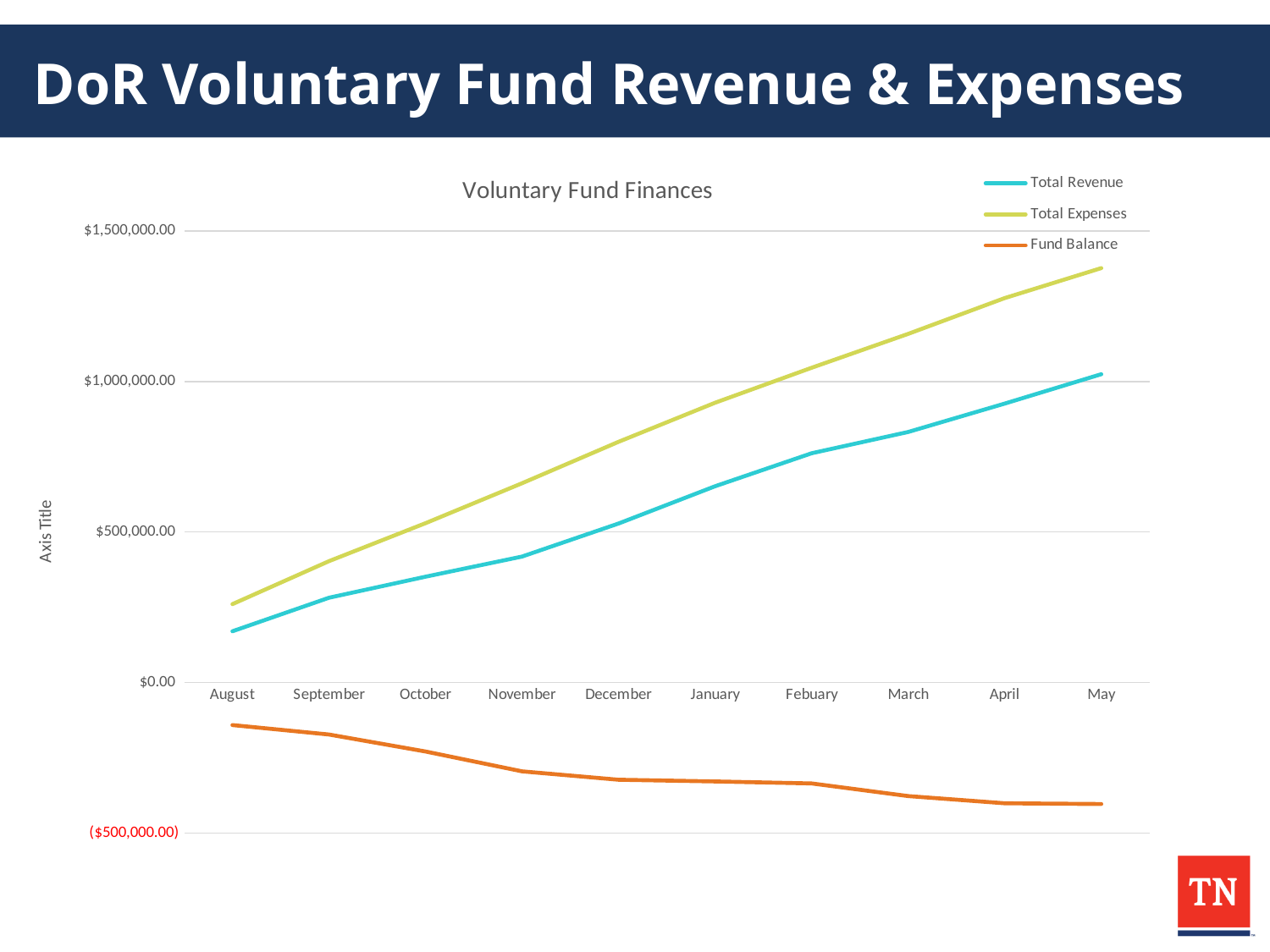
In December, which is larger: Total Expenses or Total Revenue? Total Expenses What kind of chart is shown on the slide? line chart Does Total Revenue rise or fall from August to May? rise In which month is Total Expenses highest? May Does Fund Balance rise or fall from August to May? fall How many series does the legend list? 3 Which series is drawn in orange? Fund Balance Is the value for Total Revenue in August greater or less than $500,000.00? less Is the value for Total Expenses in May greater or less than $1,000,000.00? greater What is the title of the chart? Voluntary Fund Finances In which month is Total Revenue lowest? August How many months are plotted along the x axis? 10